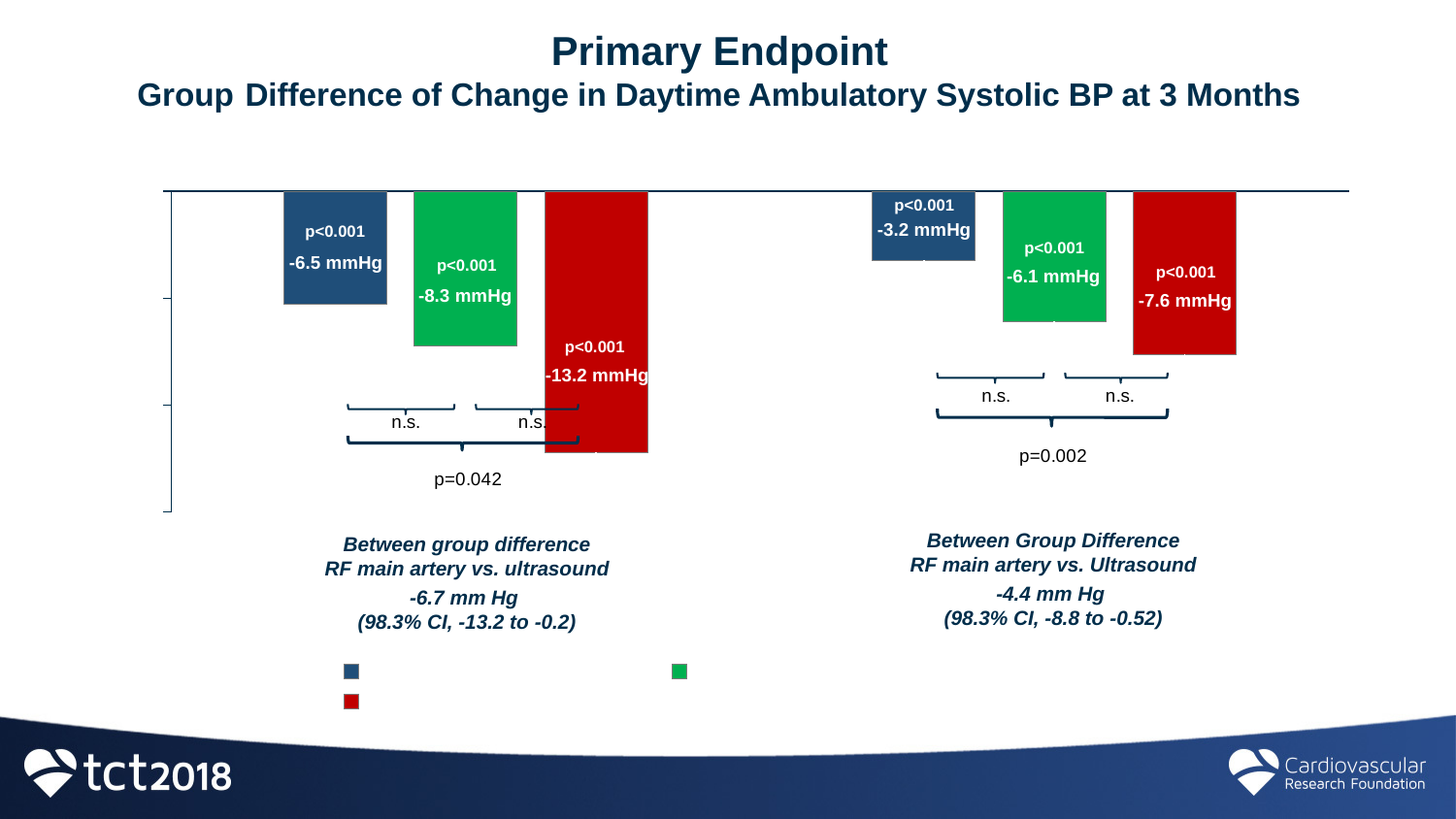
In the left chart, what value is printed on the blue bar? -6.5 mmHg In the right chart, what value is printed on the green bar? -6.1 mmHg What p-value is printed under the left chart for the overall comparison bracket? p=0.042 In the left chart, what is the difference between the red bar (-13.2 mmHg) and the green bar (-8.3 mmHg)? 4.9 mmHg In the right chart, which coloured bar shows the smallest reduction in systolic BP? blue What type of chart is used on this slide? bar chart How many bars are plotted in the left chart? 3 In the left chart, what value is printed on the red bar? -13.2 mmHg In the right chart, which bar shows a larger reduction, the green bar or the red bar? red In the right chart, what is the difference between the red bar (-7.6 mmHg) and the blue bar (-3.2 mmHg)? 4.4 mmHg In the right chart, what value is printed on the blue bar? -3.2 mmHg In the left chart, which coloured bar shows the largest reduction in systolic BP? red